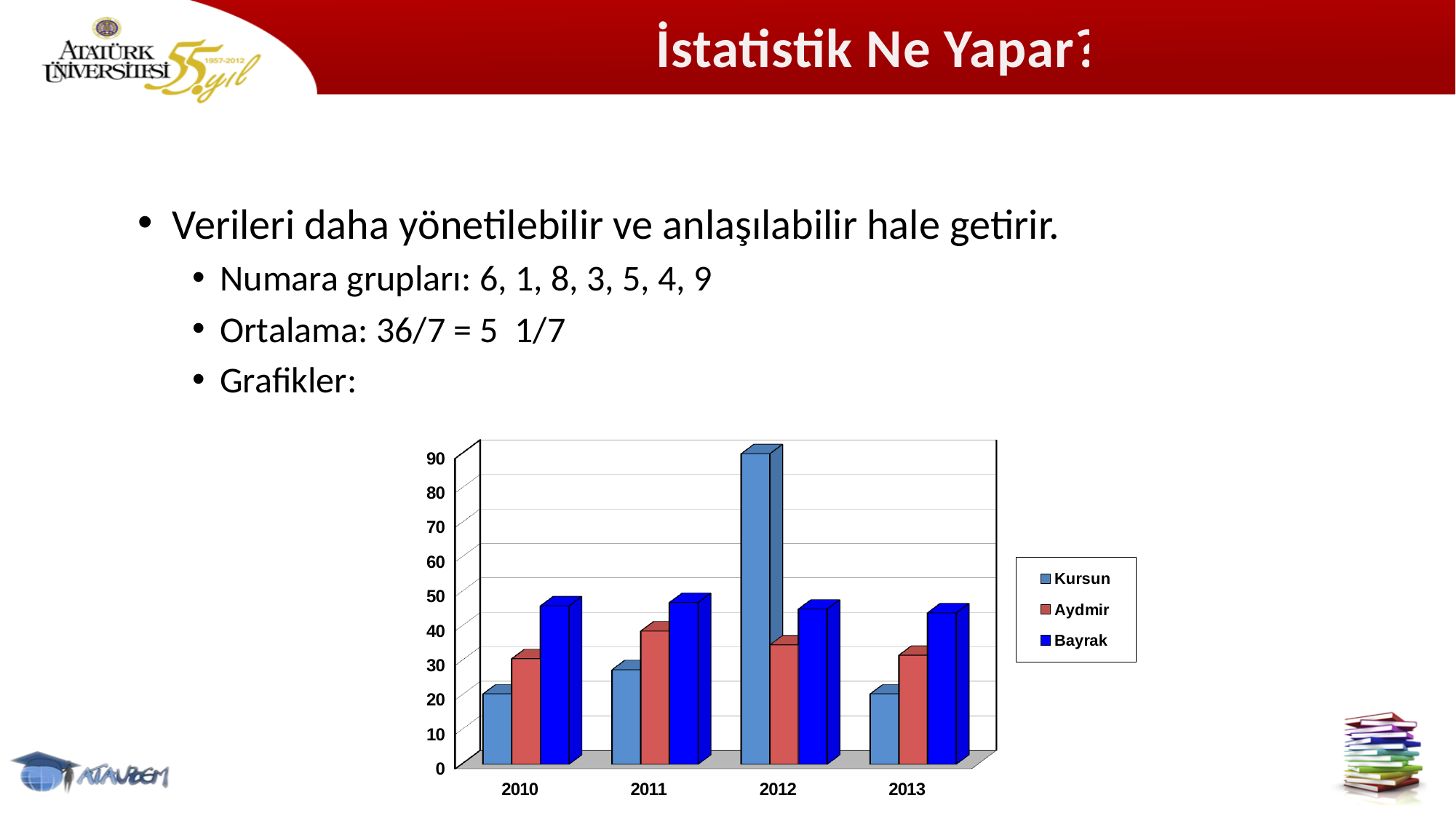
In 2012, which is larger: the Kursun value or the Aydmir value? Kursun In which year is the Kursun value highest? 2012 How many years are shown on the x axis of the chart? 4 What kind of chart is shown on the slide? bar chart In 2011, which is larger: the Aydmir value or the Kursun value? Aydmir In 2010, which is larger: the Bayrak value or the Kursun value? Bayrak Is the Aydmir value for 2011 greater or less than 50? less Is the Kursun value for 2010 greater or less than 30? less Is the Kursun value for 2012 greater or less than 80? greater How many series does the chart legend list? 3 What are the three series names listed in the chart legend? Kursun, Aydmir, Bayrak